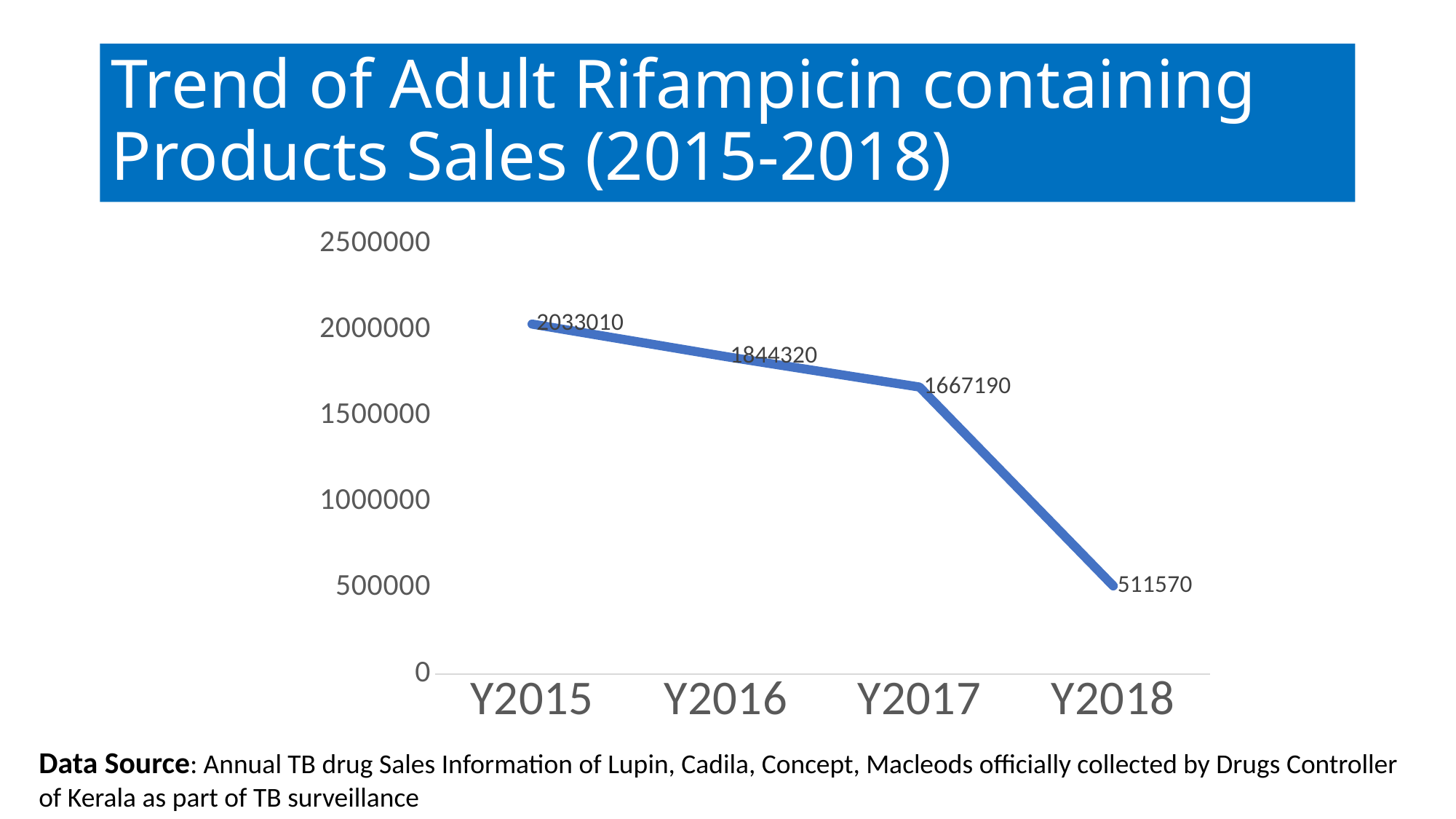
Which is larger, the value for Y2016 or the value for Y2017? Y2016 How many years are plotted on the chart? 4 What is the difference between the values for Y2015 and Y2016? 188690 Do the values rise or fall from Y2015 to Y2018? Fall What is the difference between the values for Y2017 and Y2018? 1155620 What is the value for Y2017? 1667190 What kind of chart is shown on the slide? Line chart Which year has the highest value? Y2015 Which year has the lowest value? Y2018 What is the value for Y2015? 2033010 What is the value for Y2016? 1844320 What is the value for Y2018? 511570